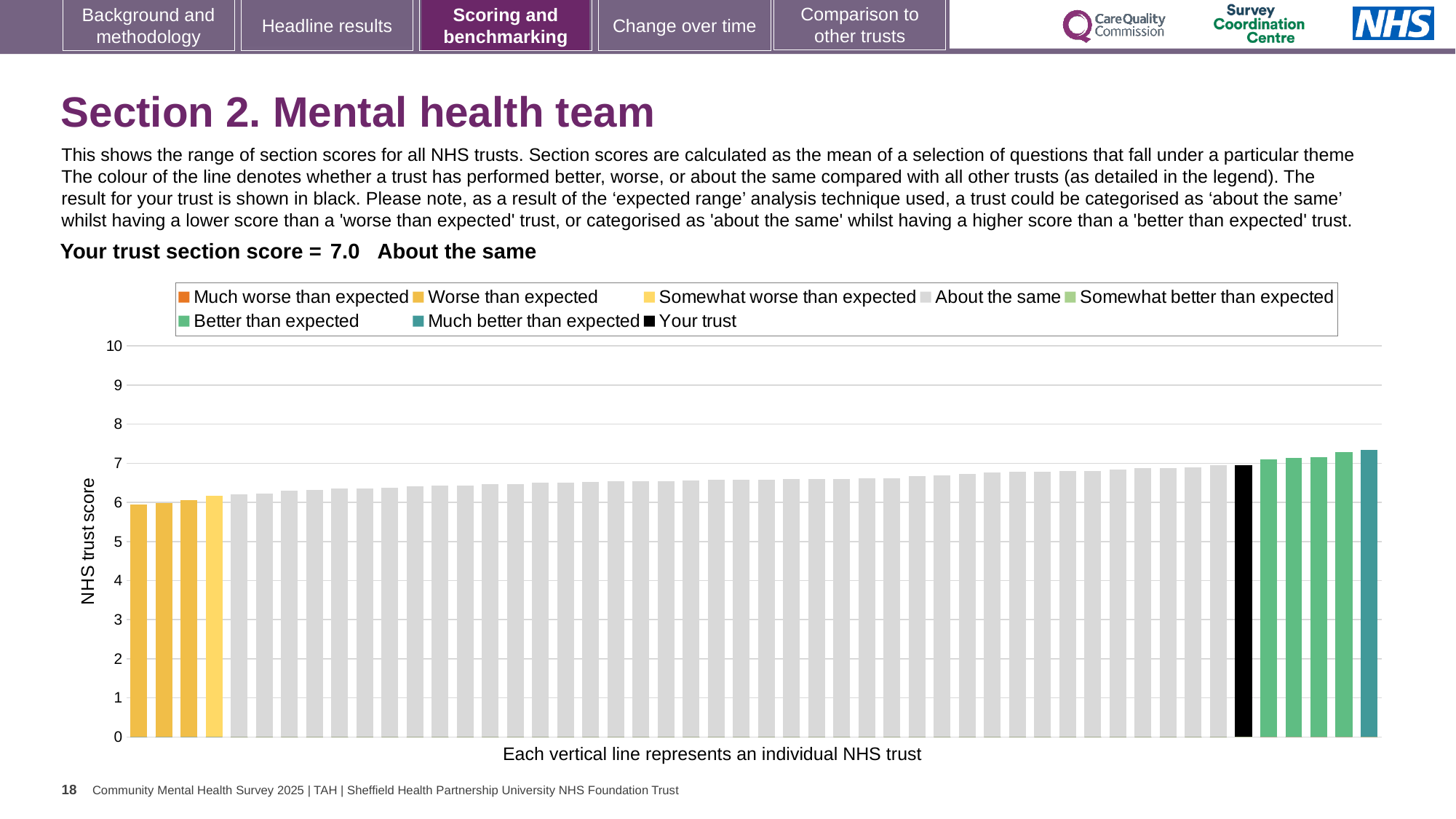
Which performance category is your trust placed in for this section? About the same Is the value of the highest bar in the chart greater or less than 7? greater What colour is the bar representing your trust? black What is the section score for your trust shown on the slide? 7.0 Do the bar values rise or fall from left to right along the x axis? rise What kind of chart is shown on the slide? bar chart How many entries does the chart legend list? 8 How many bars are shown to the right of the black 'Your trust' bar? 5 What is the label on the y axis of the chart? NHS trust score Is the value of the lowest bar in the chart greater or less than 5? greater Which legend category does the tallest bar in the chart belong to? Much better than expected